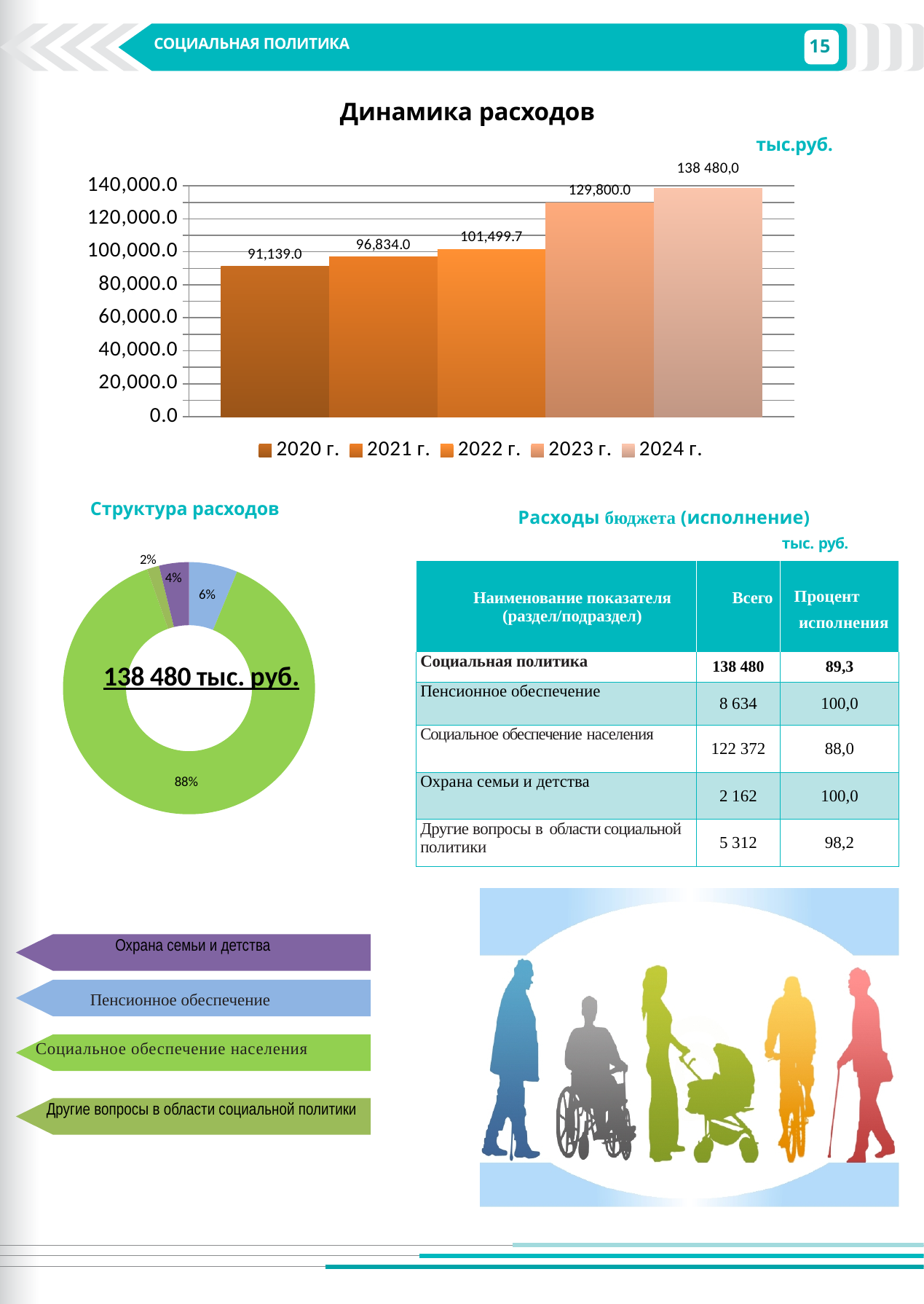
In the 'Динамика расходов' chart, which year has the lowest value? 2020 г. In the 'Структура расходов' chart, what share does 'Социальное обеспечение населения' have? 88% In the 'Динамика расходов' chart, what is the value for 2020 г.? 91,139.0 In the 'Динамика расходов' chart, what is the value for 2024 г.? 138 480,0 In the 'Динамика расходов' chart, what is the value for 2023 г.? 129,800.0 In the 'Динамика расходов' chart, which year has the highest value? 2024 г. In the 'Структура расходов' chart, what share does 'Пенсионное обеспечение' have? 6% What kind of chart is 'Динамика расходов'? bar chart In the 'Динамика расходов' chart, how many series does the legend list? 5 In the 'Динамика расходов' chart, what is the difference between the values for 2021 г. and 2020 г.? 5,695.0 In the 'Динамика расходов' chart, do the values rise or fall from 2020 г. to 2024 г.? rise In the 'Структура расходов' chart, which category has the smallest share? Охрана семьи и детства